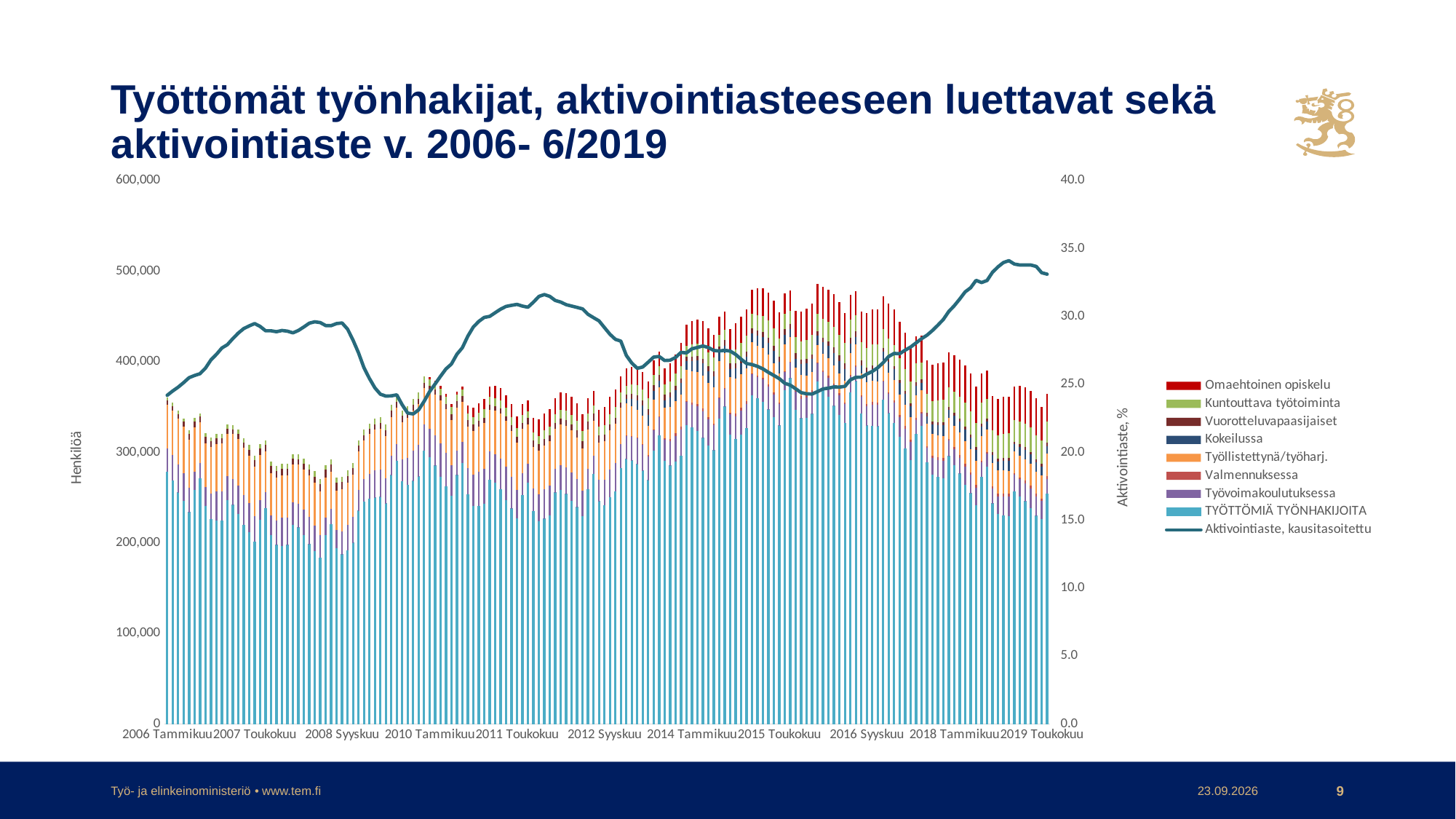
Is the lowest point of the Aktivointiaste, kausitasoitettu line greater or less than 20.0? greater Does the Aktivointiaste, kausitasoitettu line rise or fall between 2016 Syyskuu and 2018 Tammikuu? rise Is the total height of the stacked bar at 2015 Toukokuu greater or less than 400,000? greater What is the title of the chart on the slide? Työttömät työnhakijat, aktivointiasteeseen luettavat sekä aktivointiaste v. 2006- 6/2019 Is the TYÖTTÖMIÄ TYÖNHAKIJOITA bar at 2006 Tammikuu greater or less than 200,000? greater Does the Aktivointiaste, kausitasoitettu line rise or fall between 2008 Syyskuu and 2010 Tammikuu? fall What kind of chart is shown on the slide? A stacked bar chart combined with a line Which series is plotted as a line rather than as bars? Aktivointiaste, kausitasoitettu How many series does the legend list? 9